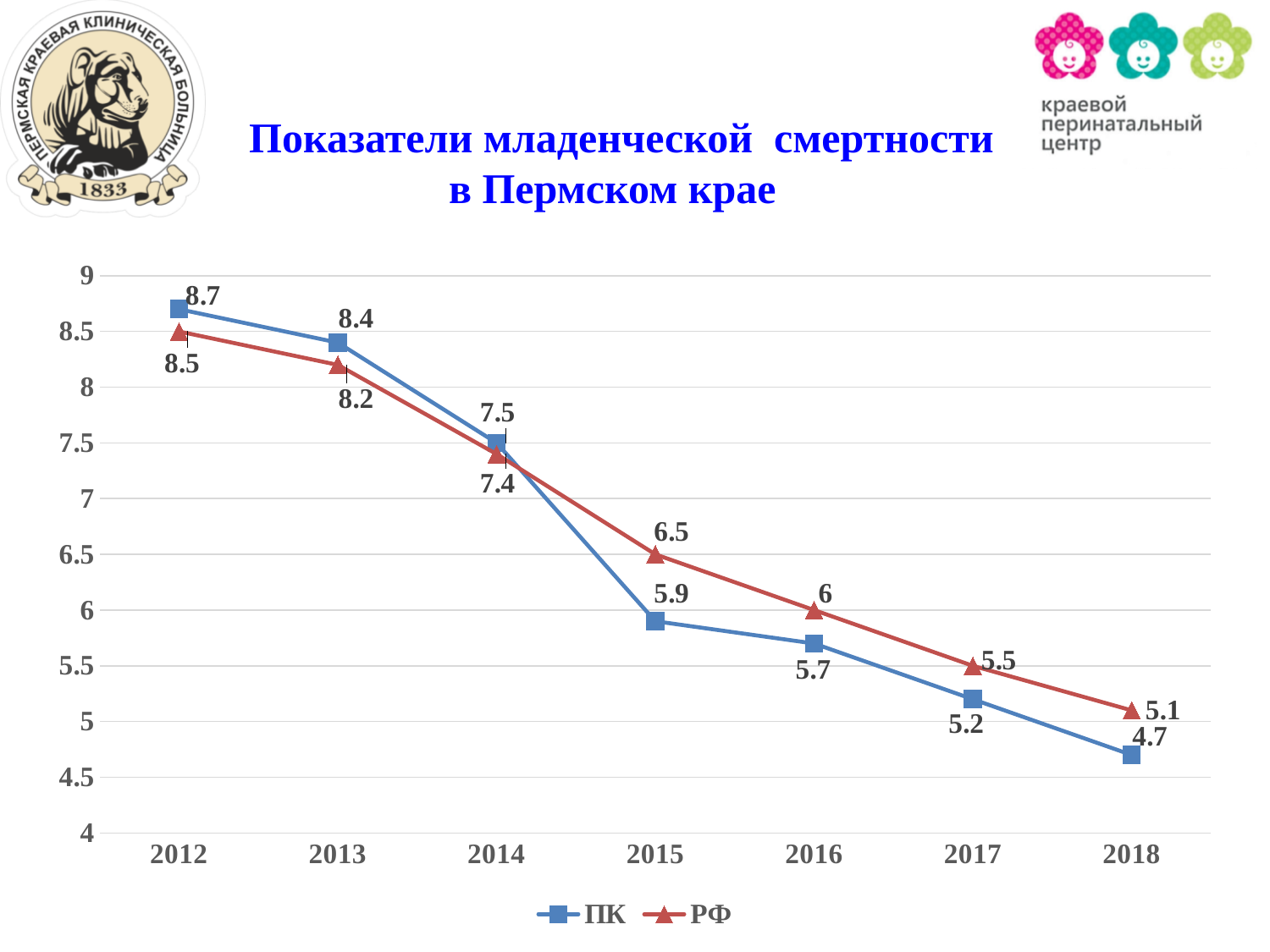
In which year is the ПК series at its lowest? 2018 How many years are shown on the x axis? 7 What is the value for РФ in 2016? 6 Do the ПК values rise or fall from 2012 to 2018? Fall How many series does the legend list? 2 In which year is the РФ series at its highest? 2012 What is the value for ПК in 2012? 8.7 Which series has the larger value in 2017, ПК or РФ? РФ What is the difference between the РФ and ПК values in 2015? 0.6 Which series has the larger value in 2013, ПК or РФ? ПК What is the value for ПК in 2018? 4.7 What kind of chart is shown on the slide? Line chart